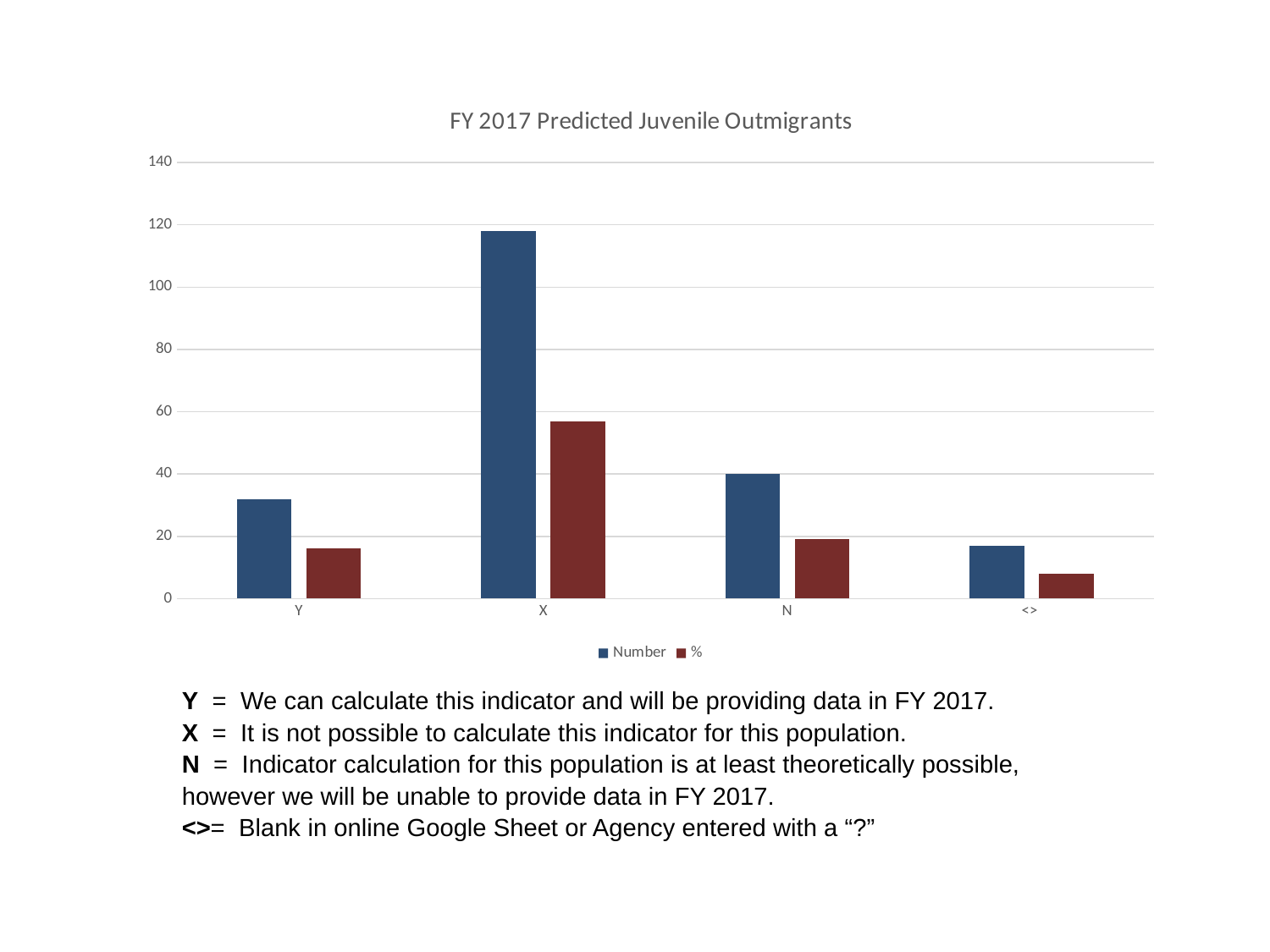
Is the Number value for Y greater or less than 20? greater How many series does the legend list? 2 Which category has the highest Number value? X Which category has the lowest Number value? <> Is the Number value for X greater or less than 100? greater What are the two series named in the legend? Number and % How many categories are shown on the x axis? 4 Which category has the highest % value? X Which is larger, the Number value for N or the Number value for Y? N What is the title of the chart? FY 2017 Predicted Juvenile Outmigrants What kind of chart is shown on the slide? bar chart Is the % value for X greater or less than 60? less